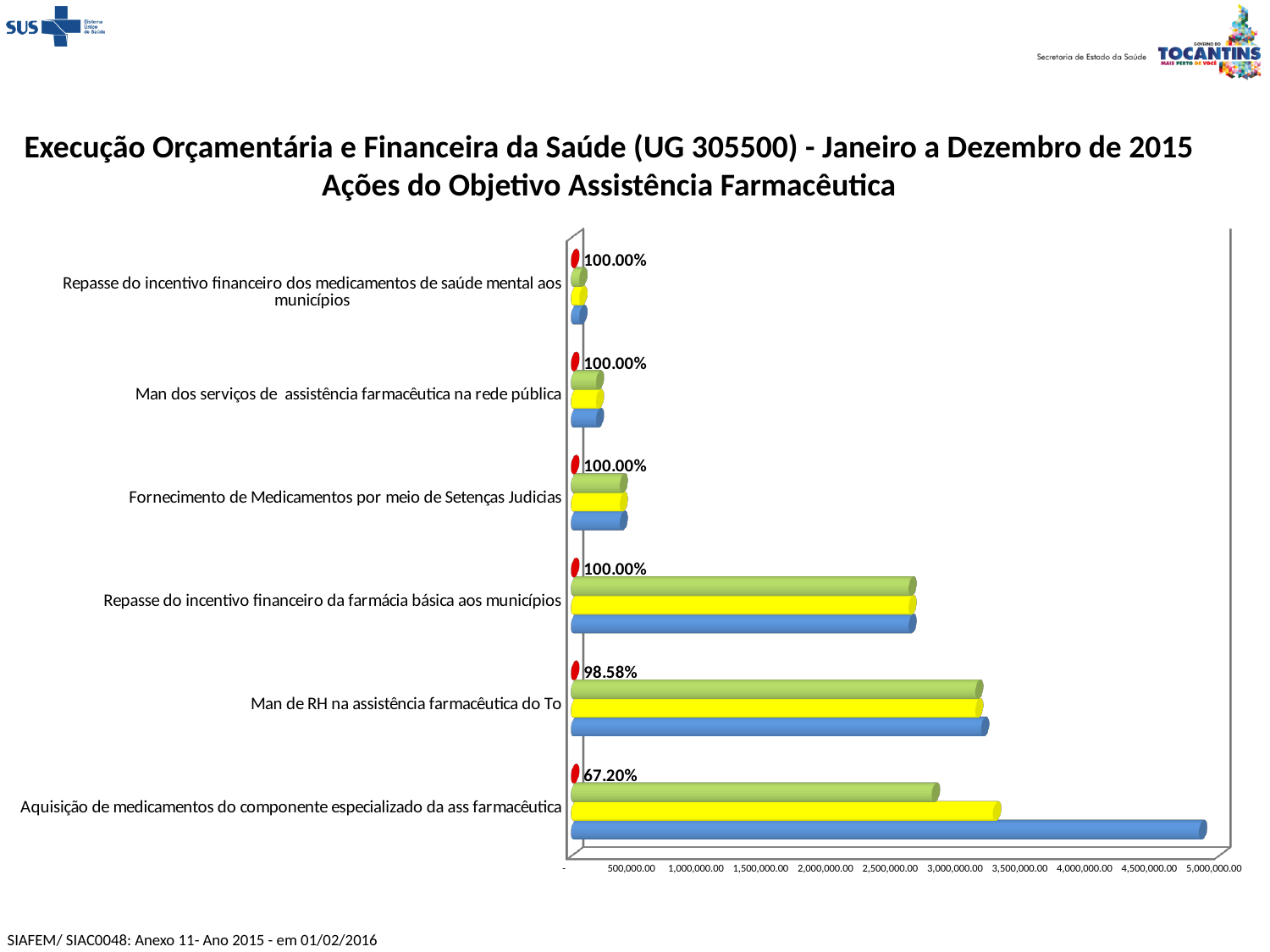
What kind of chart is shown on the slide? Bar chart Is the blue bar for "Man de RH na assistência farmacêutica do To" greater or less than 3,500,000.00? less What percentage is shown for "Aquisição de medicamentos do componente especializado da ass farmacêutica"? 67.20% Which category has the lowest percentage label? Aquisição de medicamentos do componente especializado da ass farmacêutica Which has the higher percentage label: "Man de RH na assistência farmacêutica do To" or "Aquisição de medicamentos do componente especializado da ass farmacêutica"? Man de RH na assistência farmacêutica do To What is the highest value shown on the horizontal axis? 5,000,000.00 What percentage is shown for "Fornecimento de Medicamentos por meio de Setenças Judicias"? 100.00% Is the blue bar for "Aquisição de medicamentos do componente especializado da ass farmacêutica" greater or less than 4,500,000.00? greater What is the difference between the percentage for "Repasse do incentivo financeiro da farmácia básica aos municípios" and the percentage for "Aquisição de medicamentos do componente especializado da ass farmacêutica"? 32.80% What percentage is shown for "Man de RH na assistência farmacêutica do To"? 98.58% How many categories are plotted on the chart? 6